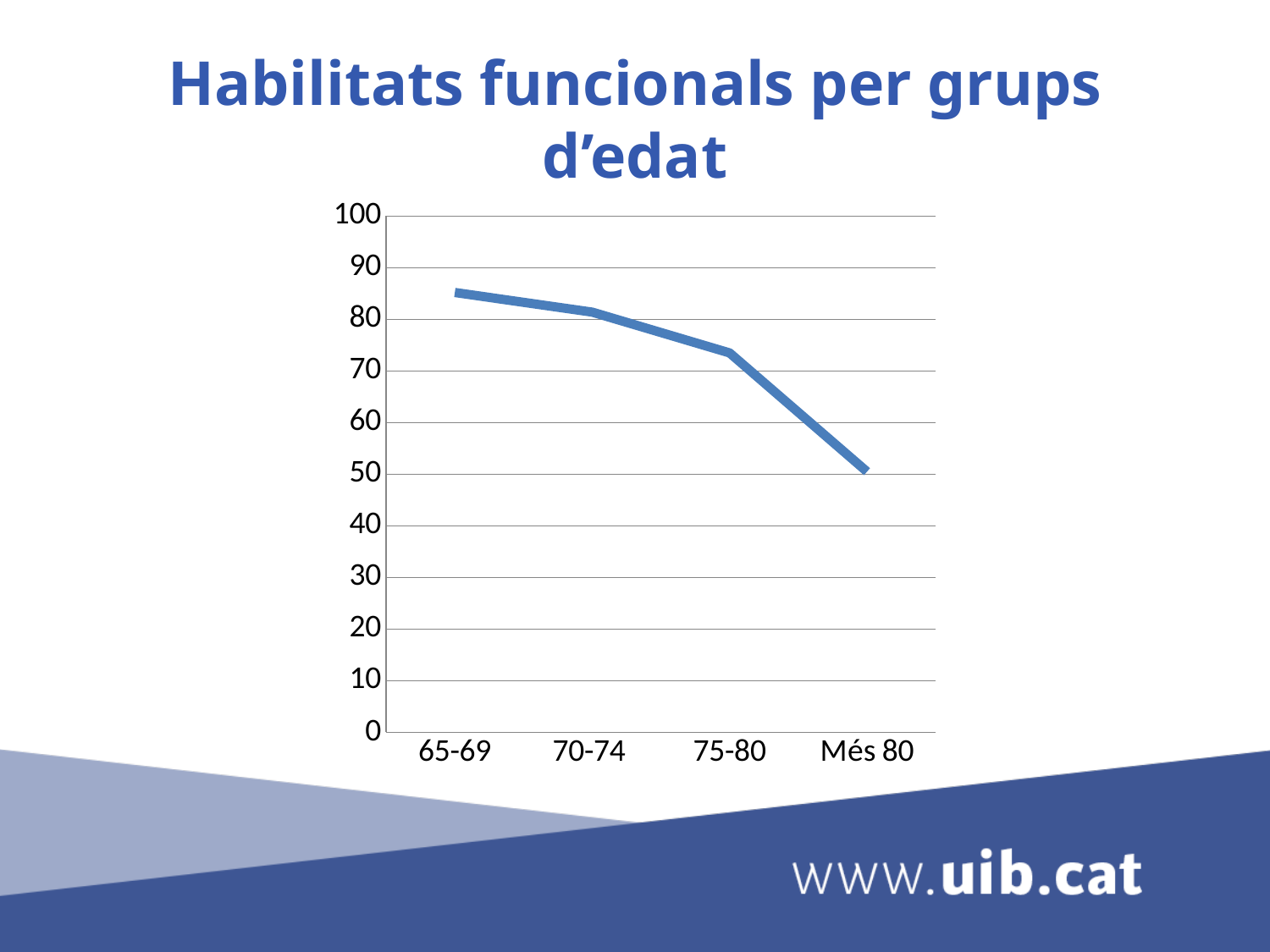
What is the title of the slide containing the chart? Habilitats funcionals per grups d'edat Is the value for 70-74 greater or less than 70? greater Which age group has the highest value? 65-69 Is the value for Més 80 greater or less than 60? less Which has the larger value, 75-80 or Més 80? 75-80 How many age groups are plotted along the x axis? 4 Which age group has the lowest value? Més 80 Do the values rise or fall as the age groups increase along the x axis? fall What kind of chart is shown on the slide? line chart Is the value for 75-80 greater or less than 60? greater Which has the larger value, 65-69 or 75-80? 65-69